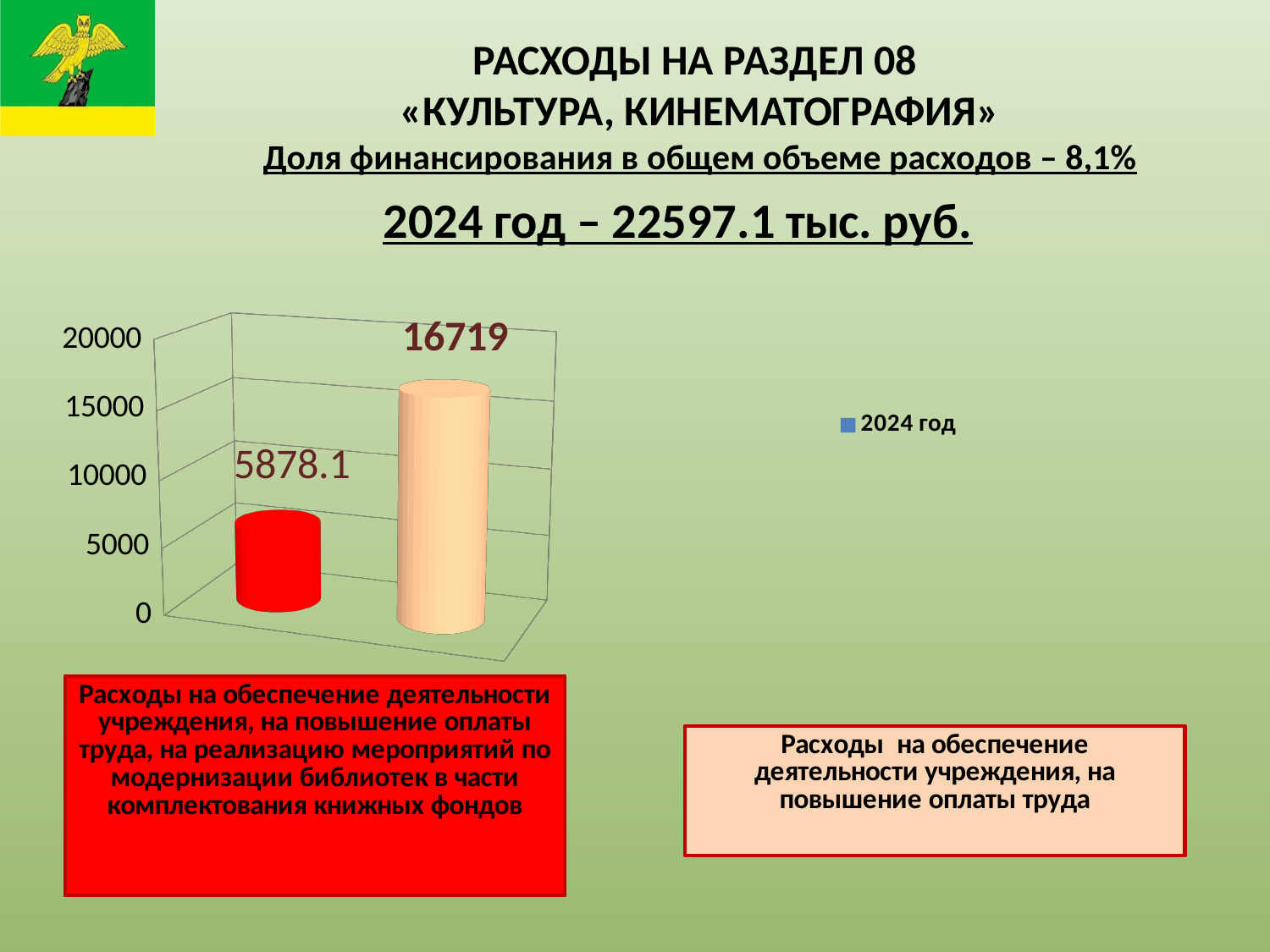
Is the value of the peach bar greater or less than 15000? greater What is the legend entry of the chart? 2024 год Which bar is the highest, the red one or the peach one? the peach one How many bars are plotted in the chart? 2 Is the value of the red bar larger or smaller than the value of the peach bar? smaller Which bar is the lowest, the red one or the peach one? the red one What value is shown on the peach (light orange) bar? 16719 Is the value of the red bar greater or less than 10000? less What kind of chart is shown on the slide? bar chart What is the difference between the peach bar (16719) and the red bar (5878.1)? 10840.9 How many series does the legend list? 1 What value is shown on the red bar? 5878.1